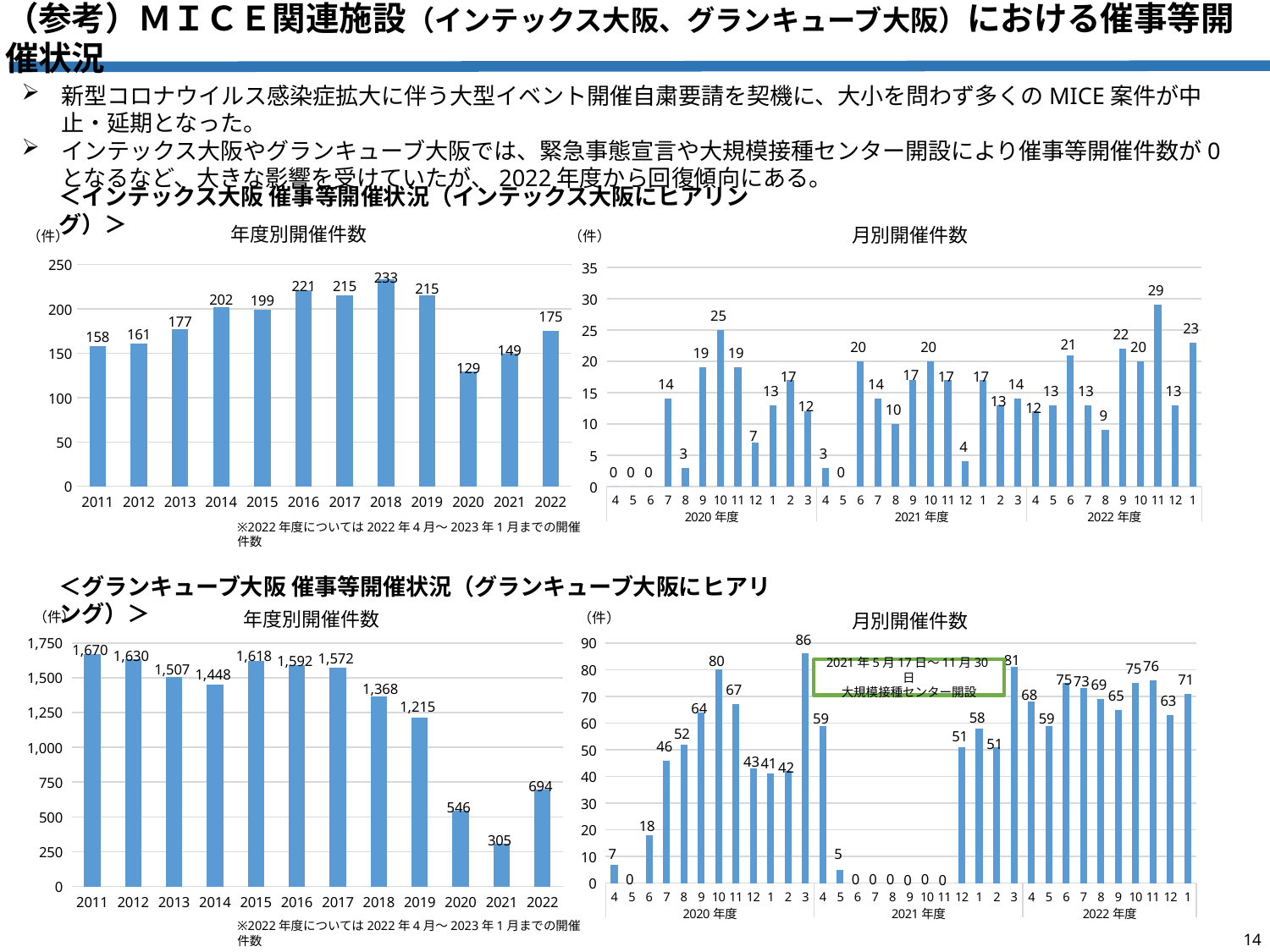
In the top-right chart (インテックス大阪 月別開催件数), what is the value for month 10 of 2020年度? 25 In the bottom-left chart (グランキューブ大阪 年度別開催件数), what is the difference between the values for 2020 and 2021? 241 In the top-left chart (インテックス大阪 年度別開催件数), what is the value for 2018? 233 In the top-left chart (インテックス大阪 年度別開催件数), how many years are plotted? 12 In the bottom-left chart (グランキューブ大阪 年度別開催件数), what is the value for 2011? 1,670 In the bottom-left chart (グランキューブ大阪 年度別開催件数), is the value for 2022 larger or smaller than the value for 2020? larger In the bottom-left chart (グランキューブ大阪 年度別開催件数), which year has the lowest value? 2021 In the bottom-right chart (グランキューブ大阪 月別開催件数), what is the value for month 3 of 2020年度? 86 In the top-left chart (インテックス大阪 年度別開催件数), which year has the lowest value? 2020 In the top-left chart (インテックス大阪 年度別開催件数), what is the difference between the values for 2019 and 2020? 86 What type of chart is the bottom-right chart (グランキューブ大阪 月別開催件数)? bar chart In the top-right chart (インテックス大阪 月別開催件数), what is the highest monthly value shown? 29